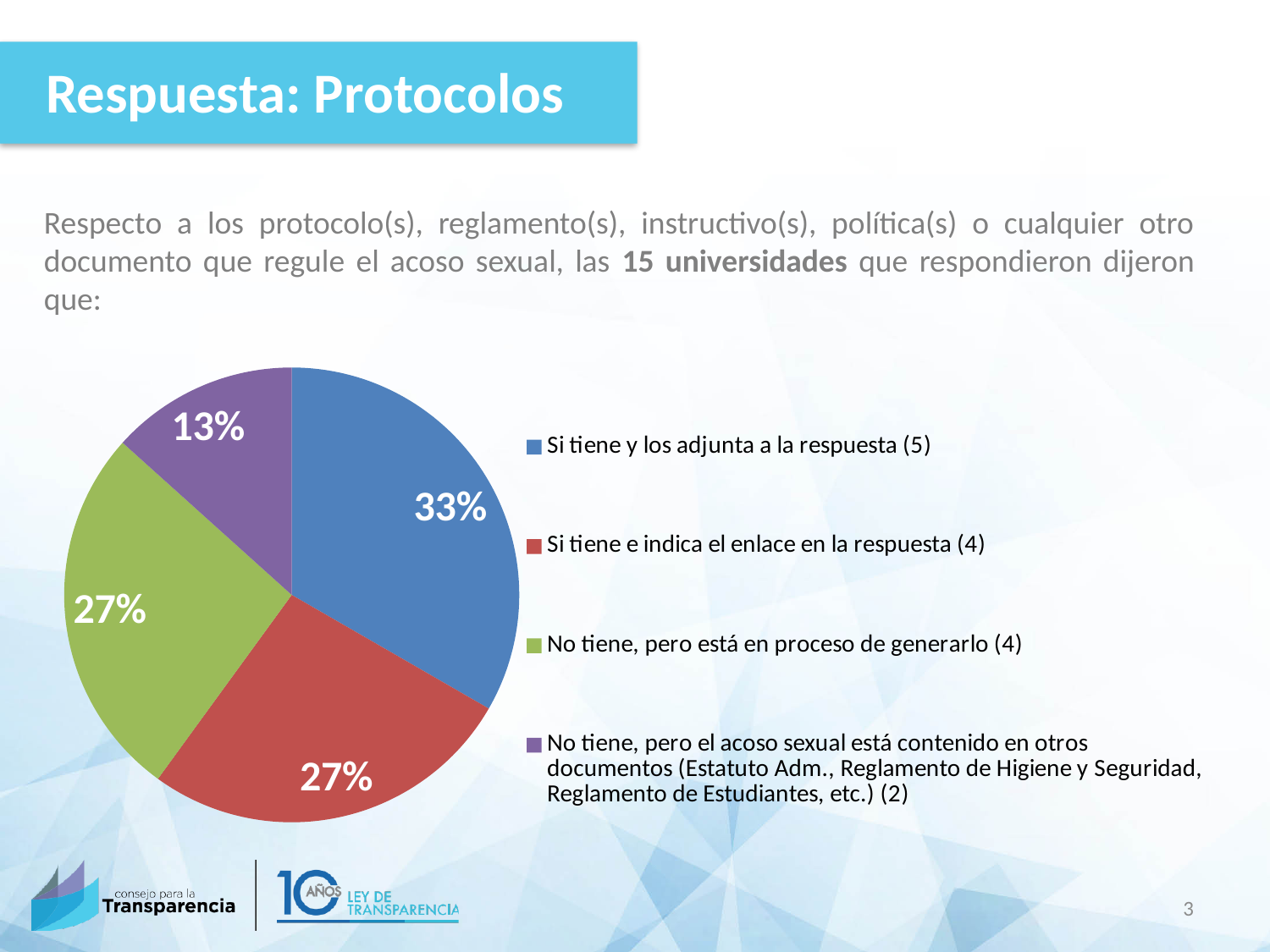
Which category has the largest share of the pie? Si tiene y los adjunta a la respuesta (5) What percentage of the pie corresponds to "Si tiene y los adjunta a la respuesta (5)"? 33% What kind of chart is shown on the slide? Pie chart What colour is the slice for "Si tiene e indica el enlace en la respuesta (4)"? Red What is the difference in percentage points between the "Si tiene y los adjunta a la respuesta (5)" slice and the "No tiene, pero el acoso sexual está contenido en otros documentos" slice? 20 percentage points How many entries does the legend of the pie chart list? 4 Which is larger: the share for "Si tiene y los adjunta a la respuesta (5)" or the share for "No tiene, pero está en proceso de generarlo (4)"? Si tiene y los adjunta a la respuesta (5) What percentage of the pie corresponds to "Si tiene e indica el enlace en la respuesta (4)"? 27% How many slices does the pie chart have? 4 What percentage of the pie corresponds to "No tiene, pero está en proceso de generarlo (4)"? 27% Which category has the smallest share of the pie? No tiene, pero el acoso sexual está contenido en otros documentos (Estatuto Adm., Reglamento de Higiene y Seguridad, Reglamento de Estudiantes, etc.) (2) What percentage of the pie corresponds to "No tiene, pero el acoso sexual está contenido en otros documentos (Estatuto Adm., Reglamento de Higiene y Seguridad, Reglamento de Estudiantes, etc.) (2)"? 13%